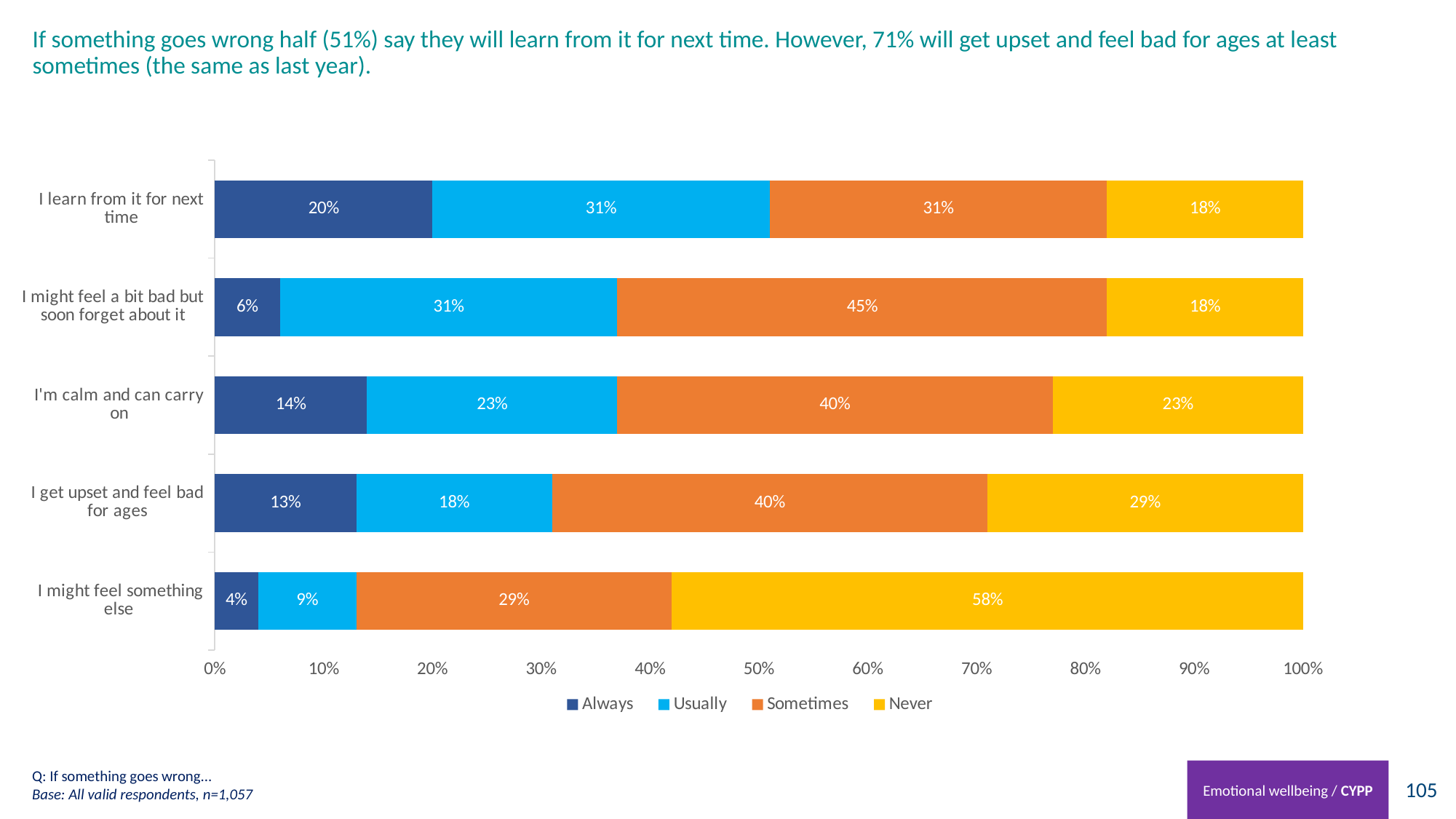
Which colour represents the 'Sometimes' series in the legend? Orange What is the combined 'Always' and 'Usually' value for 'I learn from it for next time'? 51% Which category has the highest 'Never' value? I might feel something else How many series does the legend list? 4 What is the 'Sometimes' value for 'I might feel a bit bad but soon forget about it'? 45% What percentage of respondents say they 'Always' learn from it for next time? 20% Which is larger: the 'Usually' value for 'I'm calm and can carry on' or the 'Usually' value for 'I get upset and feel bad for ages'? I'm calm and can carry on What is the difference between the 'Never' values for 'I get upset and feel bad for ages' and 'I learn from it for next time'? 11% What kind of chart is shown on the slide? Stacked bar chart How many categories are shown on the chart? 5 What is the 'Never' value for 'I might feel something else'? 58% Which category has the lowest 'Always' value? I might feel something else